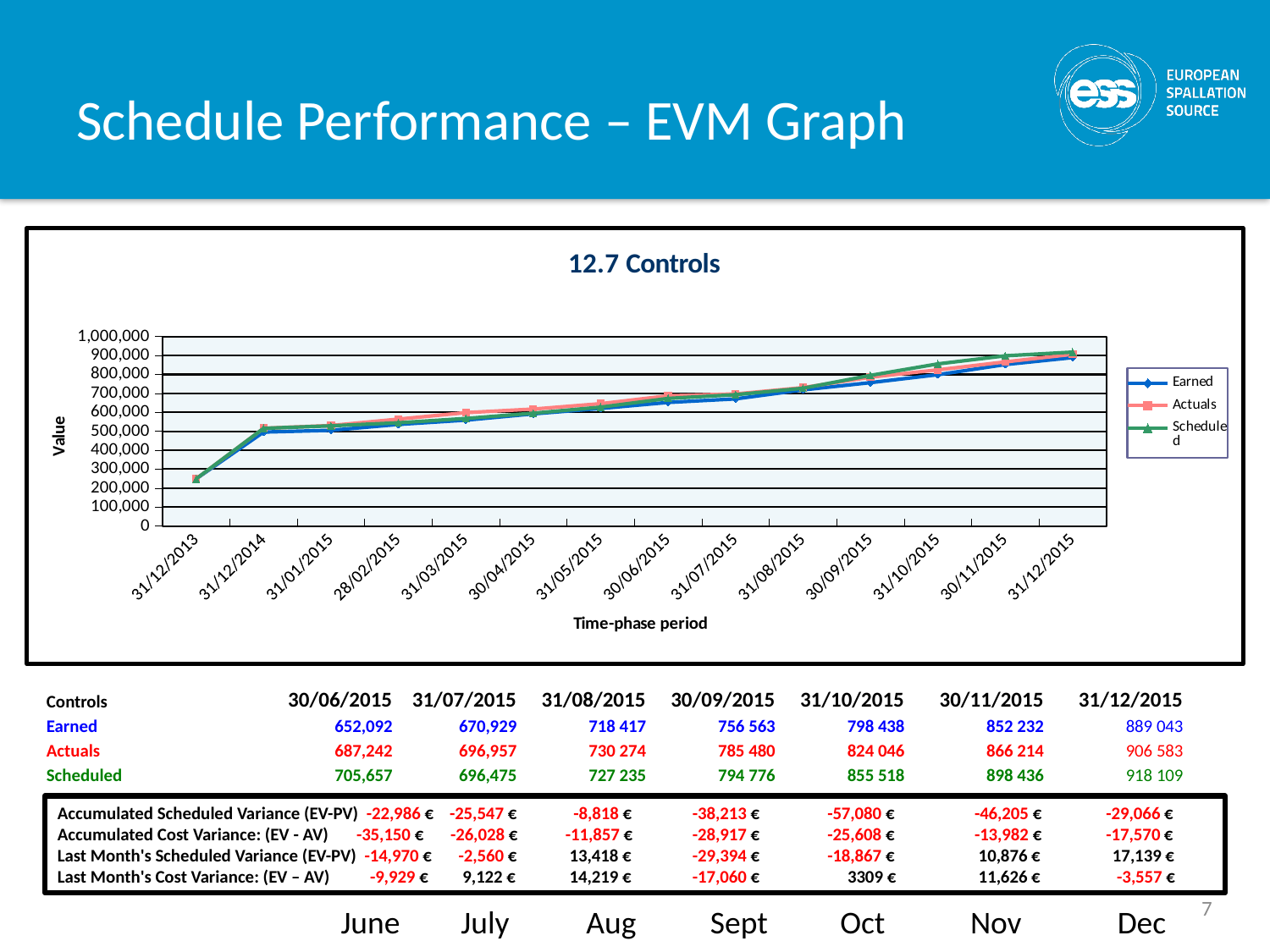
What is the Actuals value at 30/11/2015? 866 214 What is the title of the x axis of the chart? Time-phase period How many series does the chart legend list? 3 At 30/06/2015, which is larger, the Actuals value or the Earned value? Actuals Is the Scheduled value at 31/12/2014 greater or less than 400,000? greater Do the Earned values rise or fall from 31/12/2013 to 31/12/2015? rise Is the Earned value at 31/12/2013 greater or less than 200,000? greater How many time-phase periods are plotted along the x axis? 14 What is the Earned value at 31/10/2015? 798 438 What type of chart is shown on the slide? line chart Which series has the highest value at 31/12/2015? Scheduled What is the title of the chart? 12.7 Controls